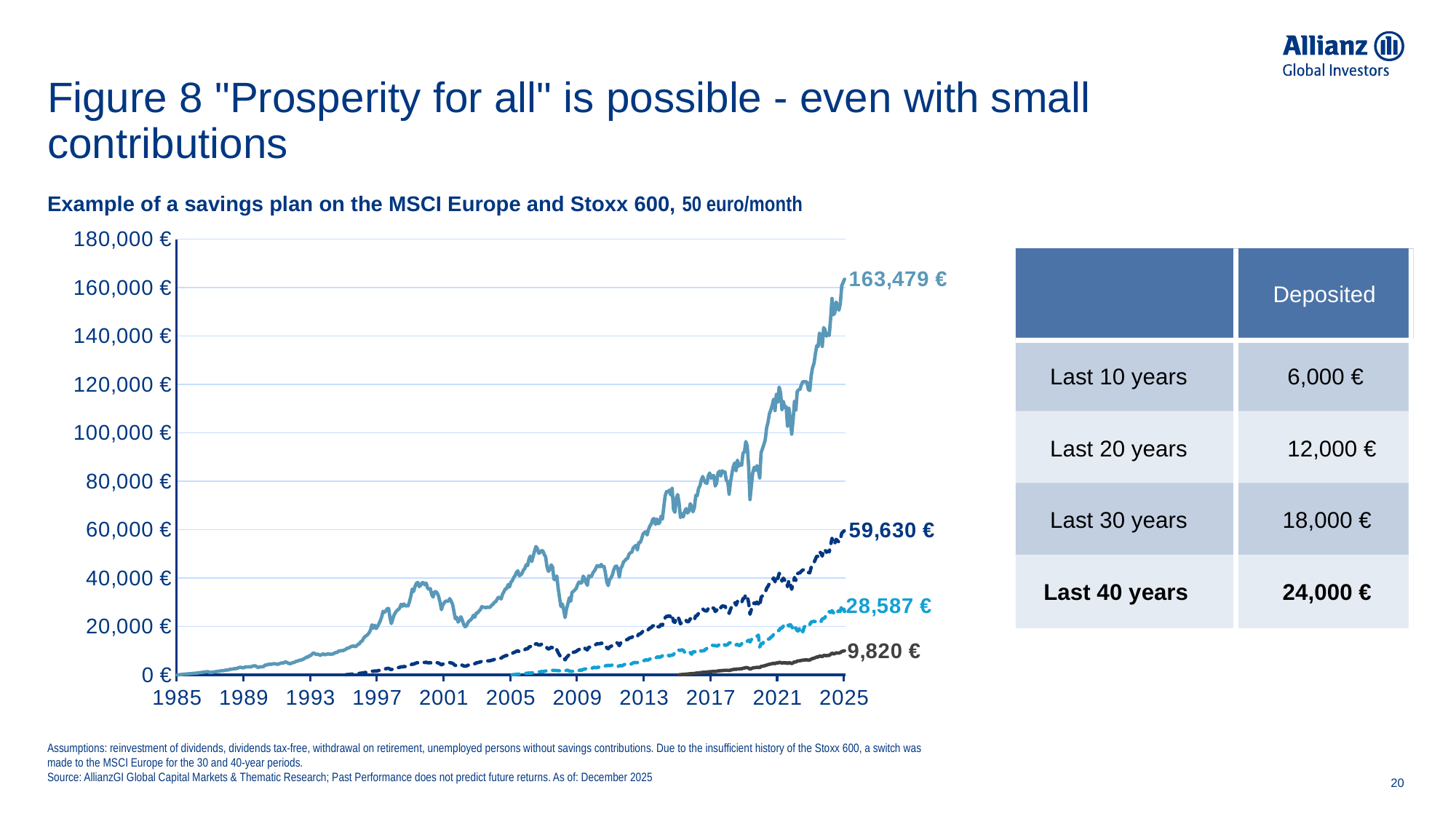
What end value is labelled on the second-highest line? 59,630 € What end value is labelled on the line that starts in 1985? 163,479 € Does the top line generally rise or fall from 1985 to 2025? rise Which labelled end value is larger, 59,630 € or 28,587 €? 59,630 € What is the lowest end value labelled on the chart? 9,820 € What is the highest value shown on the y axis of the chart? 180,000 € Is the value of the top line at 2009 greater or less than 40,000 €? less What is the highest end value labelled on the chart? 163,479 € What is the difference between the two highest labelled end values, 163,479 € and 59,630 €? 103,849 € What is the difference between the labelled end values 28,587 € and 9,820 €? 18,767 € How many lines are plotted on the chart? 4 What kind of chart is shown on the slide? line chart